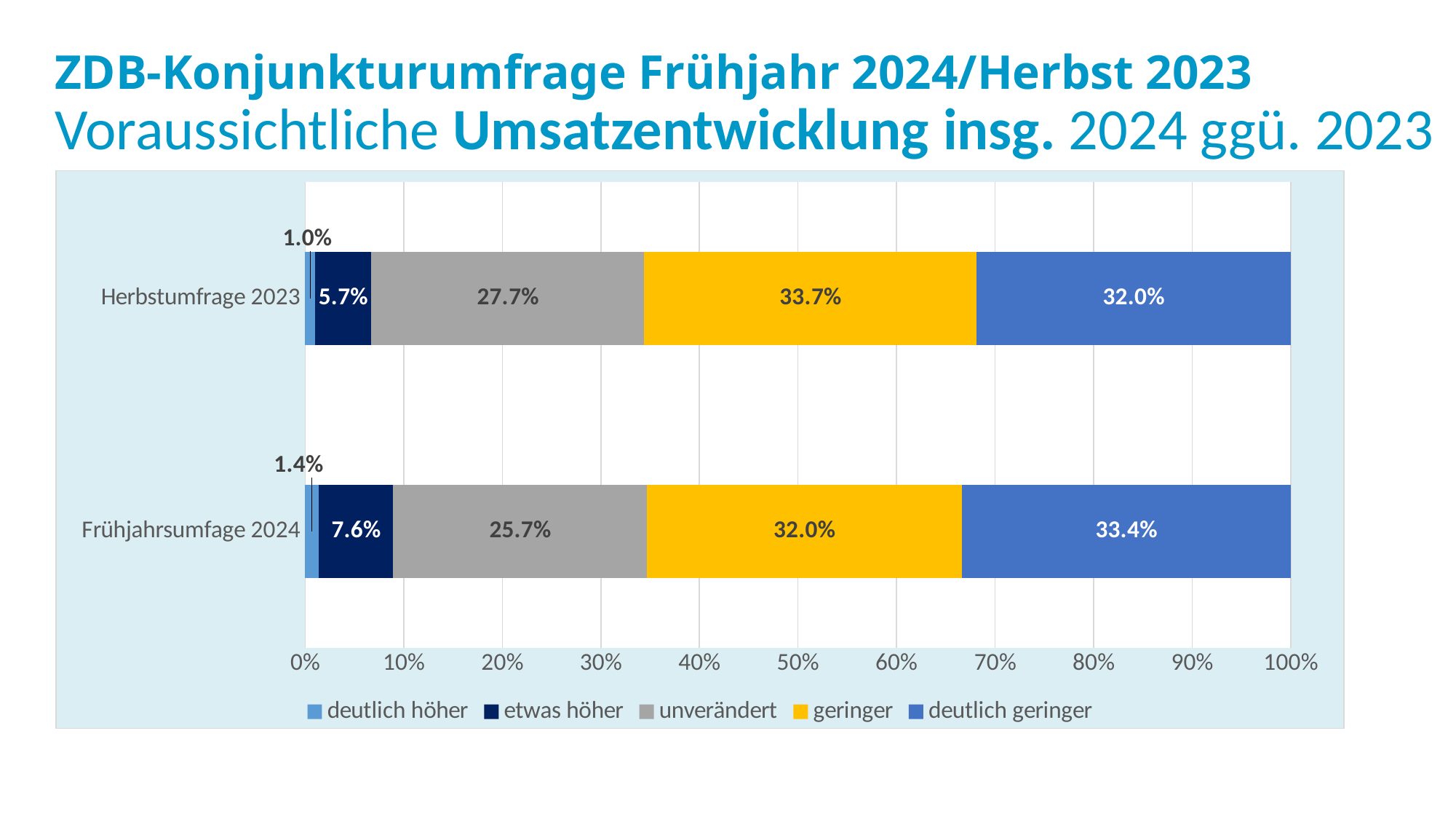
Which series has the largest share in the Herbstumfrage 2023 bar? geringer How many categories (survey rounds) are shown on the chart? 2 What is the value for 'etwas höher' in the Frühjahrsumfage 2024 bar? 7.6% What is the value for 'deutlich höher' in the Herbstumfrage 2023 bar? 1.0% Which is larger: 'unverändert' in Herbstumfrage 2023 or 'unverändert' in Frühjahrsumfage 2024? Herbstumfrage 2023 What is the value for 'unverändert' in the Herbstumfrage 2023 bar? 27.7% How many series does the legend list? 5 Which legend entry is shown in yellow? geringer What kind of chart is shown on the slide? stacked bar chart What is the value for 'deutlich geringer' in the Frühjahrsumfage 2024 bar? 33.4% Which series has the smallest share in the Frühjahrsumfage 2024 bar? deutlich höher What is the difference between the 'geringer' values for Herbstumfrage 2023 and Frühjahrsumfage 2024? 1.7 percentage points